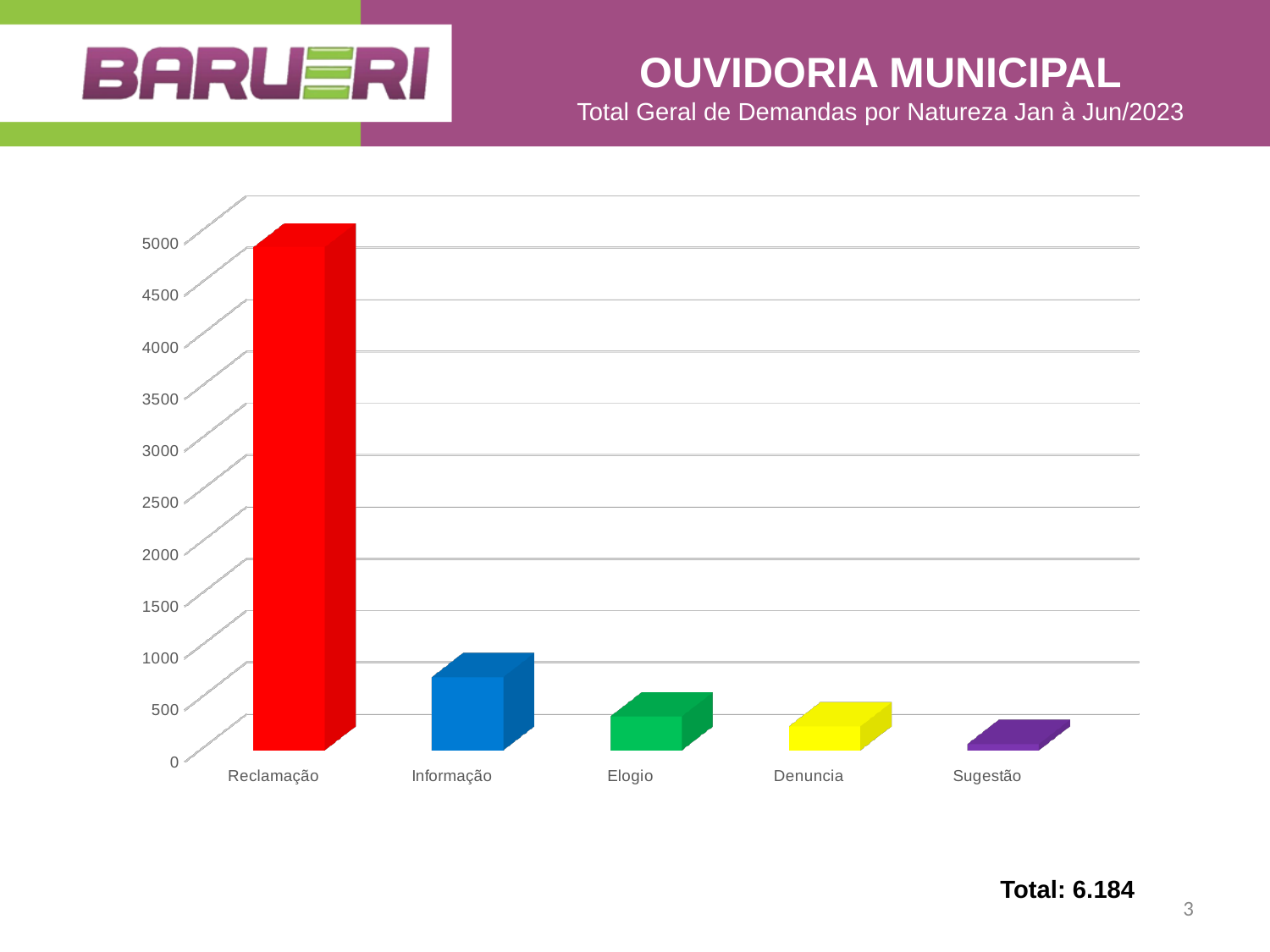
Is the value for Sugestão greater or less than 500? less Is the value for Reclamação greater or less than 4500? greater What kind of chart is shown on the slide? bar chart Which is larger, the value for Informação or the value for Elogio? Informação How many categories are shown on the x axis of the chart? 5 What total is printed below the chart? 6.184 Do the values rise or fall moving from left to right along the x axis? fall Which category has the highest value in the chart? Reclamação Is the value for Elogio greater or less than 500? less Which category has the lowest value in the chart? Sugestão Which is larger, the value for Denuncia or the value for Sugestão? Denuncia